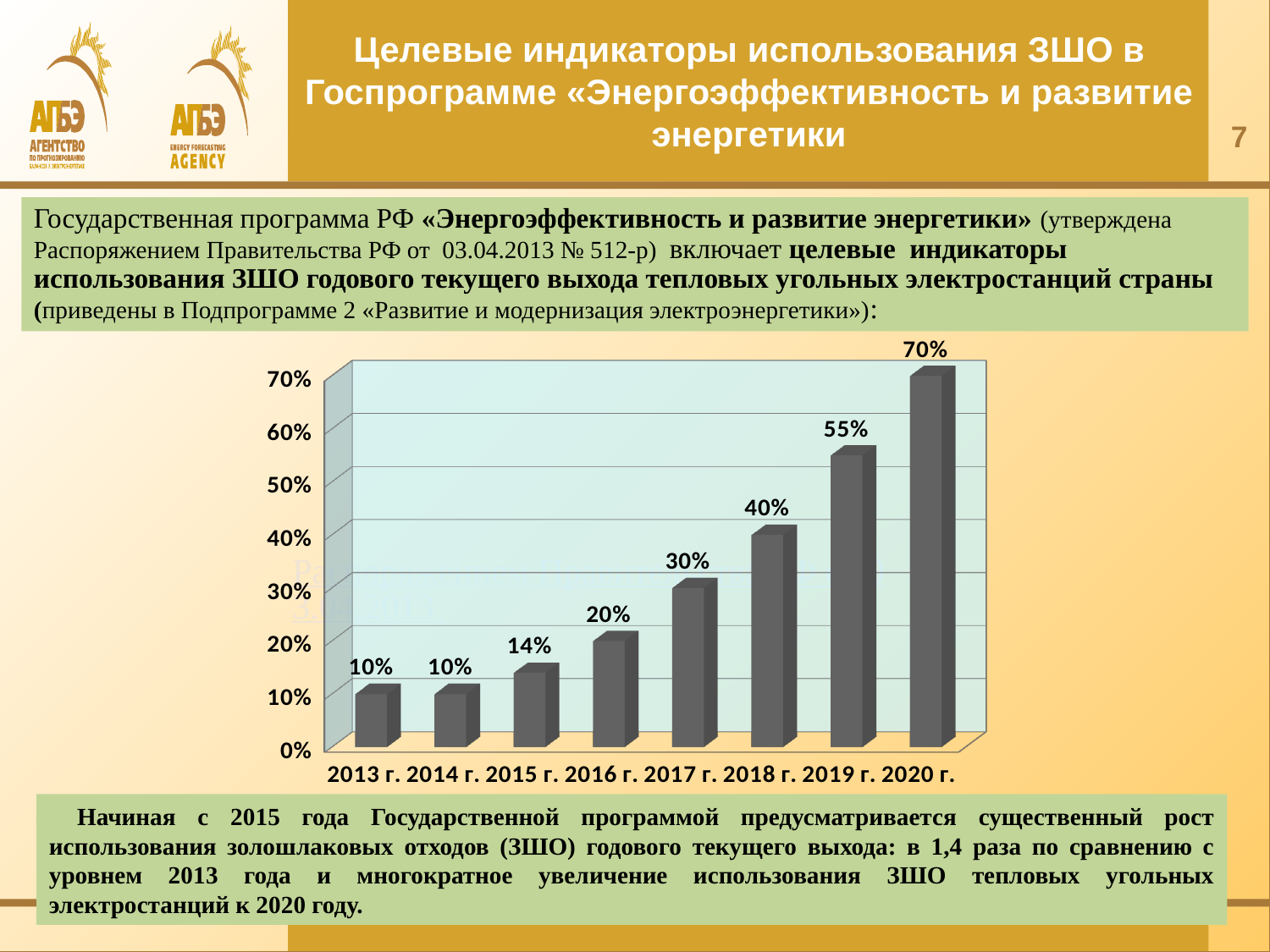
What is the value for 2015 г.? 14% What is the difference between the values for 2020 г. and 2019 г.? 15% Which two years share the same value of 10%? 2013 г. and 2014 г. Which is larger, the value for 2016 г. or the value for 2017 г.? 2017 г. What is the value for 2020 г.? 70% What is the value for 2018 г.? 40% What kind of chart is shown on the slide? bar chart Which year has the highest value? 2020 г. Do the values rise or fall from 2013 г. to 2020 г.? rise How many years are shown on the x axis? 8 What is the highest tick shown on the vertical axis? 70% What is the difference between the values for 2017 г. and 2013 г.? 20%